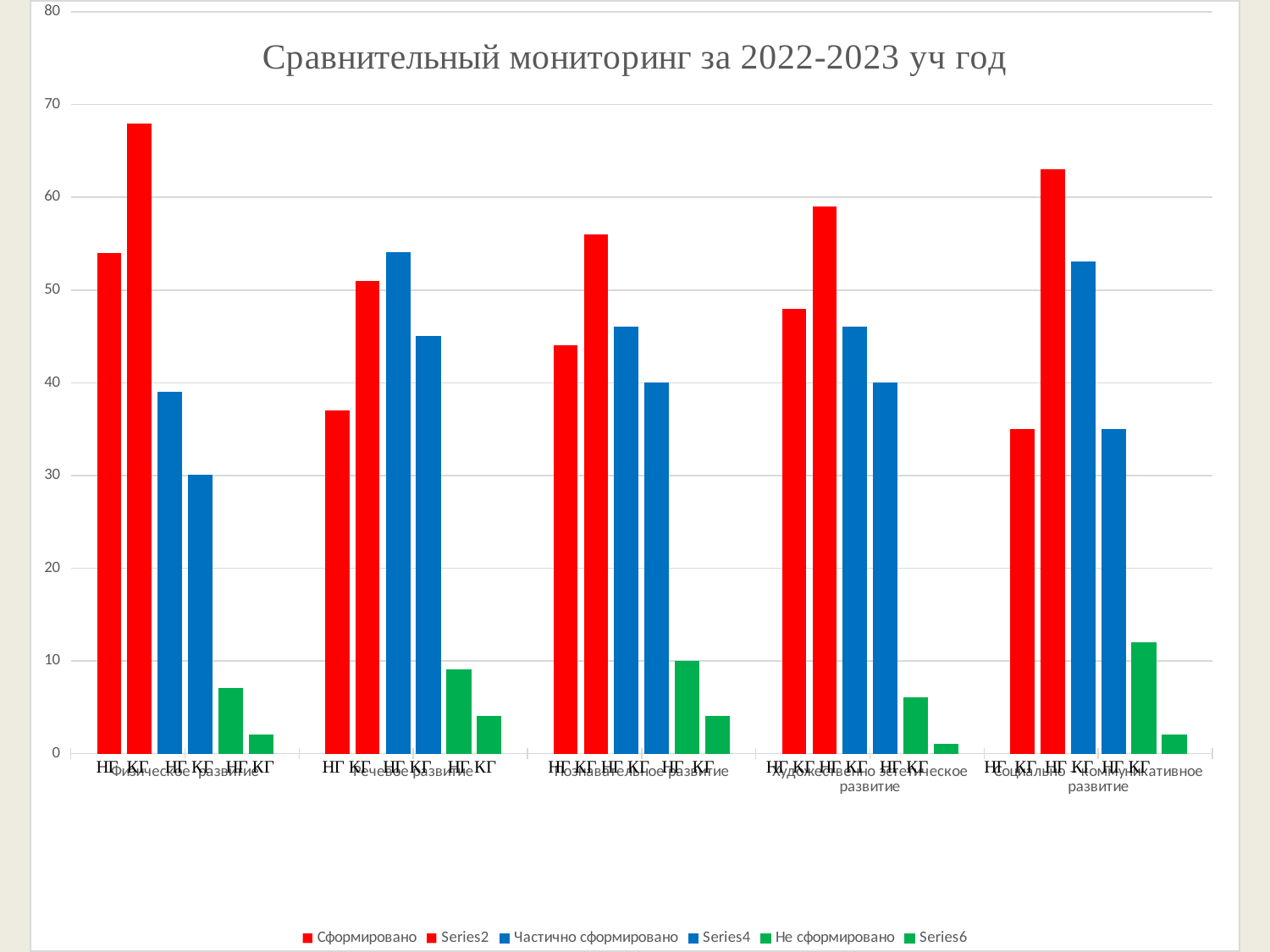
Is the НГ value for Сформировано in Социально-коммуникативное развитие greater or less than 40? less What is the title of the chart? Сравнительный мониторинг за 2022-2023 уч год Which category has the tallest КГ bar for Сформировано? Физическое развитие Is the КГ value for Не сформировано in Познавательное развитие greater or less than 10? less How many series does the legend list? 6 Is the КГ value for Сформировано in Физическое развитие greater or less than 60? greater What colour are the bars for Не сформировано? green In Физическое развитие, which is larger for Сформировано: the НГ bar or the КГ bar? КГ How many development areas (categories) are shown on the x axis? 5 Which category has the tallest НГ bar for Не сформировано? Социально-коммуникативное развитие What kind of chart is shown on the slide? bar chart